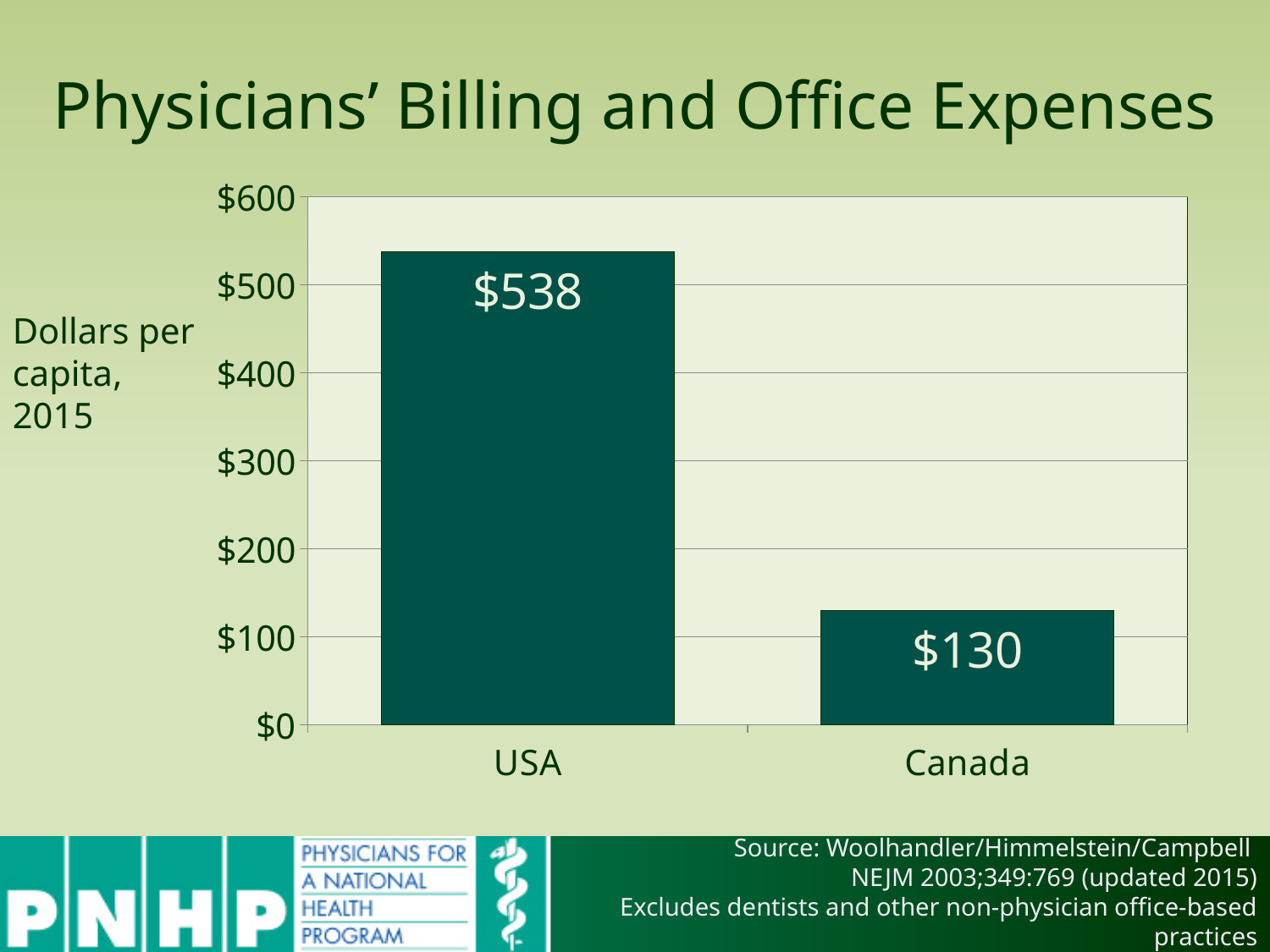
How many countries are shown in the chart? 2 What is the title of the chart? Physicians' Billing and Office Expenses Is the value for Canada greater or less than $200? less What is the difference between the USA and Canada values? $408 What kind of chart is shown on the slide? bar chart Which is larger, the value for USA or the value for Canada? USA What unit is the y axis measured in, according to the label on the slide? Dollars per capita, 2015 Is the value for USA greater or less than $500? greater Which country has the lowest physicians' billing and office expenses per capita? Canada What is the value for USA? $538 Which country has the highest physicians' billing and office expenses per capita? USA What is the value for Canada? $130